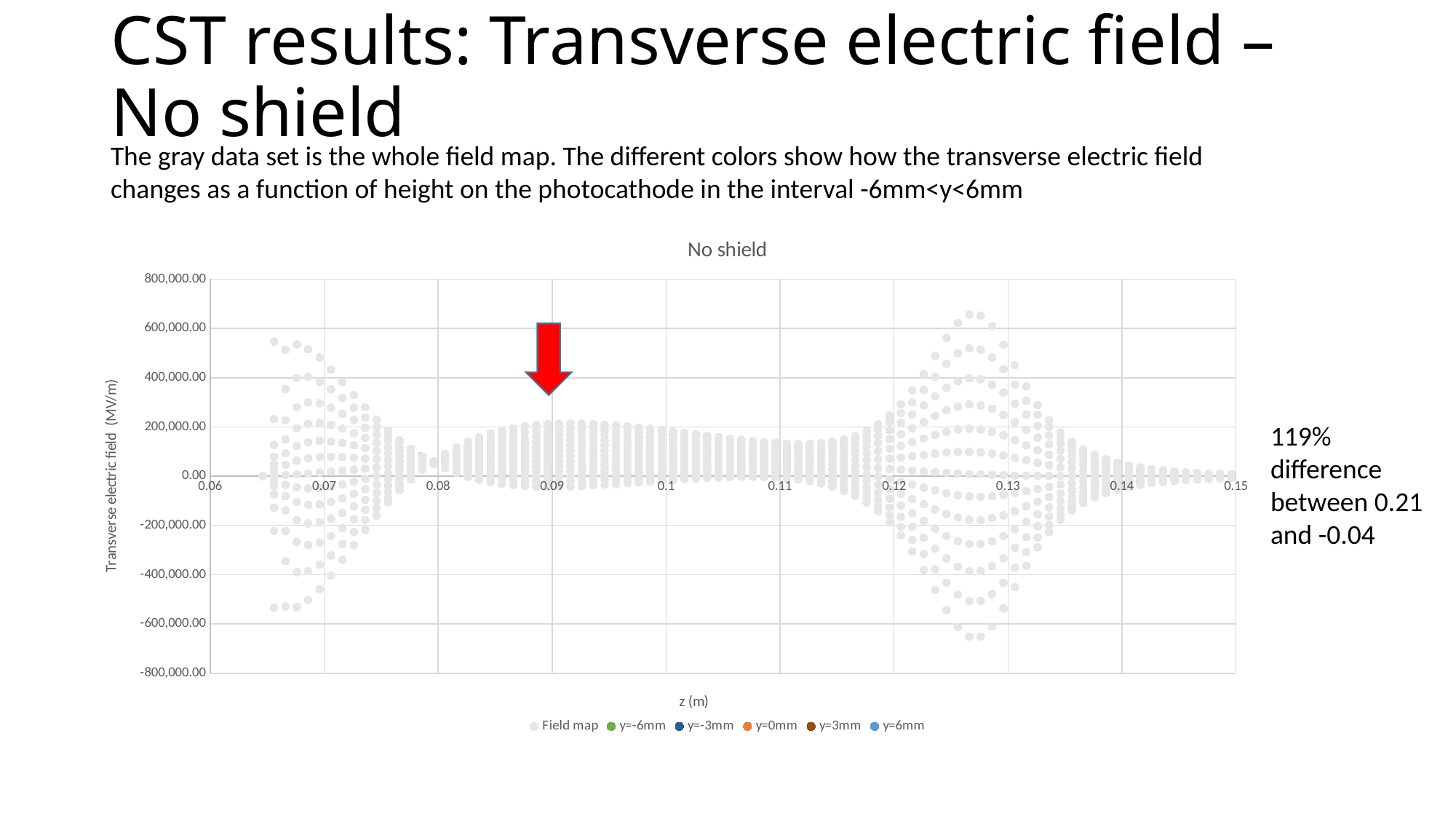
What kind of chart is shown on the slide? scatter chart What is the lowest value shown on the y axis of the chart? -800,000.00 Are the Field map values near z = 0.09 greater or less than 400,000.00? less Is the highest Field map value near z = 0.13 greater or less than 600,000.00? greater What is the label of the x axis of the chart? z (m) What is the title of the chart? No shield How many series does the chart legend list? 6 How many tick labels are shown on the x axis of the chart? 10 Is the highest Field map value near z = 0.07 greater or less than 600,000.00? less What is the largest z value shown on the x axis of the chart? 0.15 What is the highest value shown on the y axis of the chart? 800,000.00